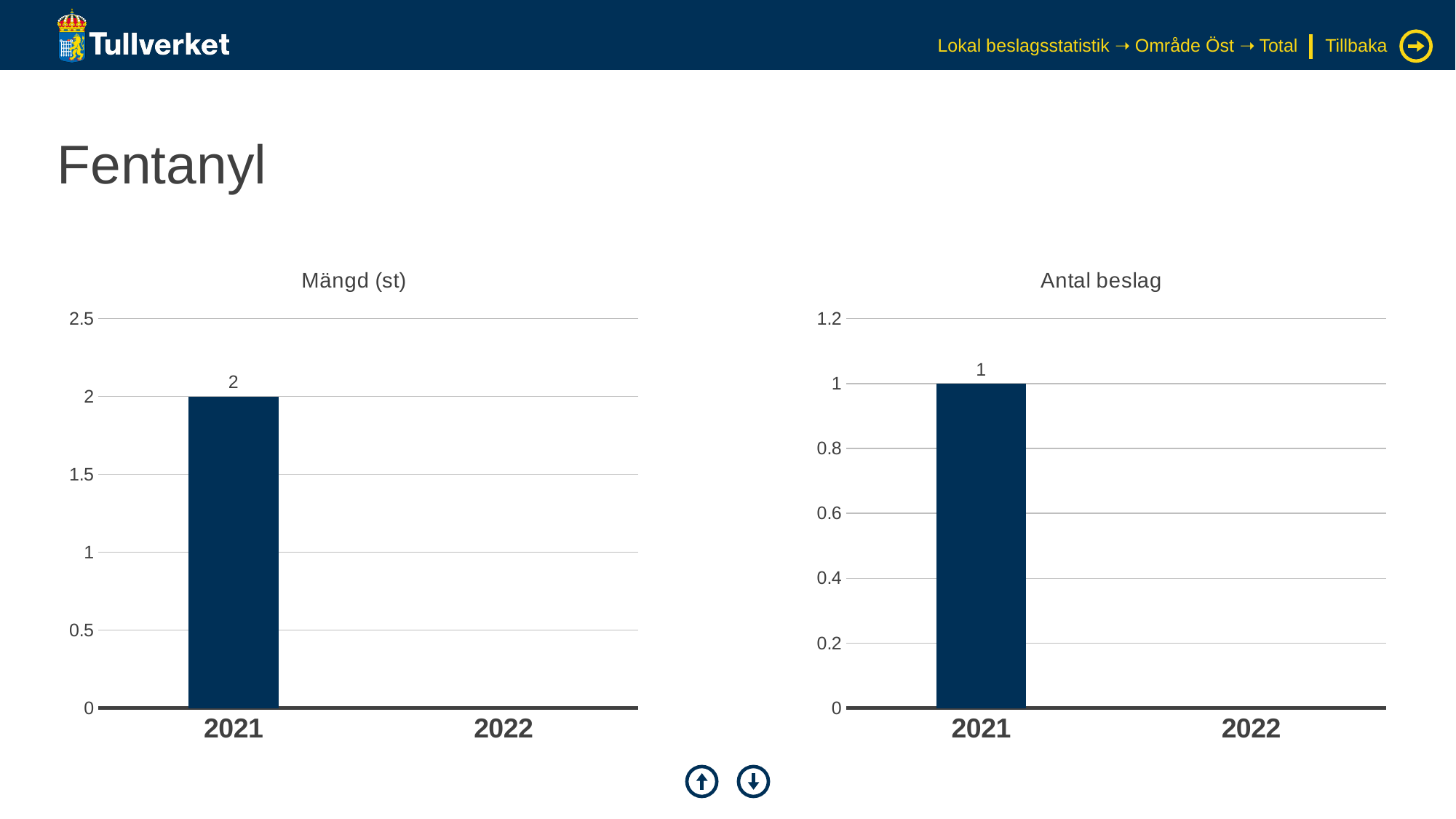
What kind of chart is the "Antal beslag" chart? Bar chart In the "Antal beslag" chart, is the value for 2021 greater or less than 1.2? less How many years are shown on the x axis of the "Antal beslag" chart? 2 In the "Antal beslag" chart, what is the value for 2021? 1 In the "Mängd (st)" chart, which year has the highest value? 2021 In the "Mängd (st)" chart, what is the highest value shown on the y axis? 2.5 What is the title of the chart on the left side of the slide? Mängd (st) In the "Mängd (st)" chart, is the value for 2021 greater or less than 1.5? greater In the "Antal beslag" chart, which year has the highest value? 2021 What is the title of the chart on the right side of the slide? Antal beslag In the "Mängd (st)" chart, what is the value for 2021? 2 How many years are shown on the x axis of the "Mängd (st)" chart? 2